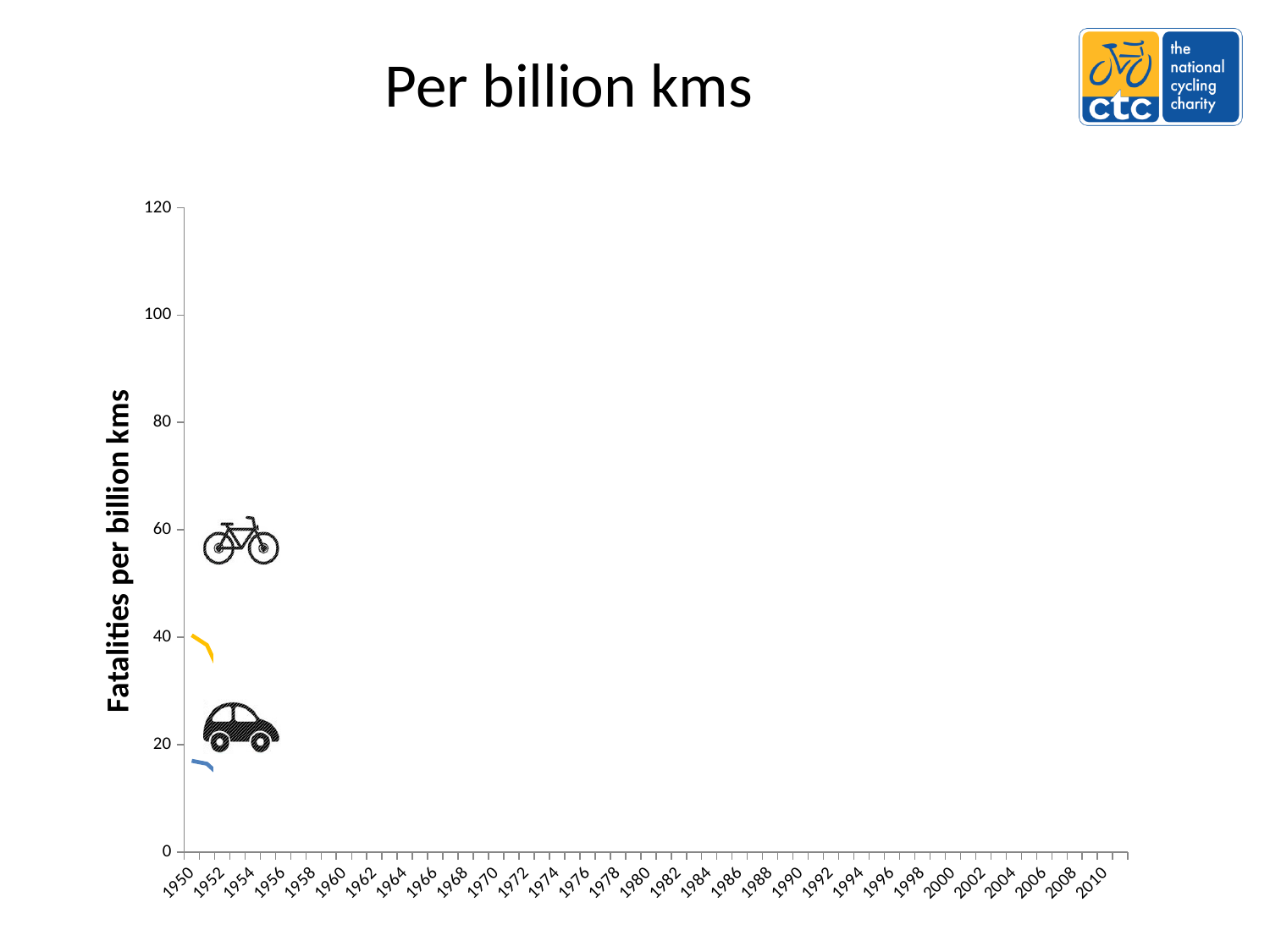
Does the blue line rise or fall from 1950 to 1951? fall Is the value of the yellow line at 1951 greater or less than 40? less How many lines are plotted on the chart? 2 What is the highest value shown on the vertical axis? 120 Which line has the higher values, the yellow line or the blue line? the yellow line What is the title of the chart? Per billion kms What is the label on the vertical axis of the chart? Fatalities per billion kms What kind of chart is shown on the slide? line chart Is the value of the yellow line at 1950 greater or less than 60? less Does the yellow line rise or fall from 1950 to 1951? fall Is the value of the blue line at 1950 greater or less than 20? less